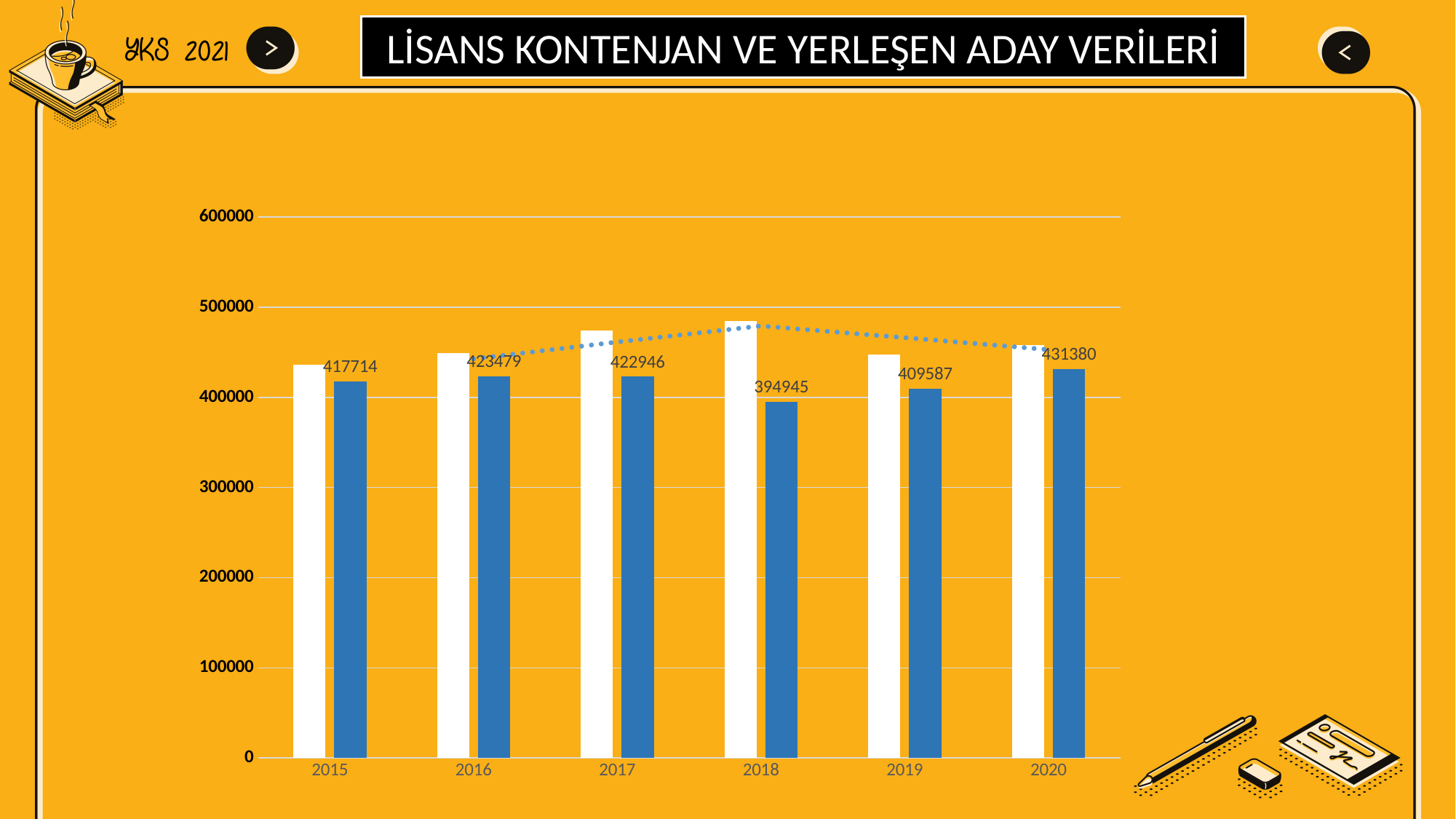
Which year has the highest value among the blue bars? 2020 How many years are shown on the x axis? 6 Is the value of the white bar for 2018 greater or less than 400000? greater Which year has the lowest value among the blue bars? 2018 What is the value of the blue bar for 2015? 417714 What is the difference between the blue bar values for 2020 and 2018? 36435 What kind of chart is shown on the slide? Bar chart What is the value of the blue bar for 2020? 431380 Which is larger, the blue bar value for 2016 or for 2017? 2016 Is the value of the white bar for 2015 greater or less than 500000? less What is the value of the blue bar for 2018? 394945 Do the blue bar values rise or fall from 2018 to 2020? Rise